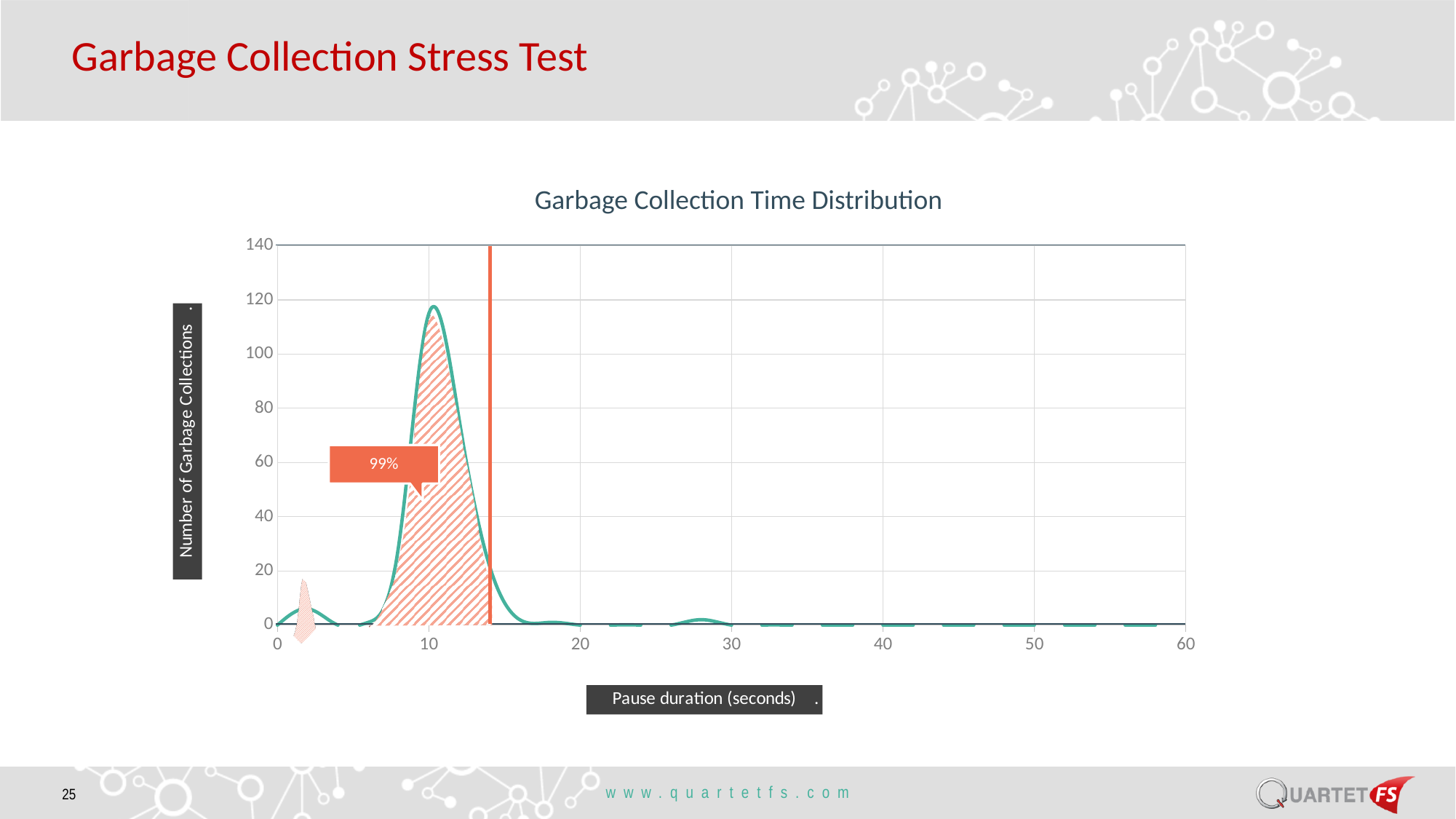
Is the value of the curve at a pause duration of 30 seconds greater or less than 20? less Between a pause duration of 6 seconds and 10 seconds, do the values rise or fall? rise Is the value of the curve at a pause duration of 2 seconds greater or less than 40? less What is the highest value shown on the x axis? 60 What is the label of the x axis? Pause duration (seconds) What kind of chart is shown on the slide? line chart Is the peak value of the curve greater or less than 100? greater Which pause duration has the higher number of garbage collections, 10 seconds or 30 seconds? 10 seconds Between a pause duration of 10 seconds and 20 seconds, do the values rise or fall? fall What is the title of the chart? Garbage Collection Time Distribution